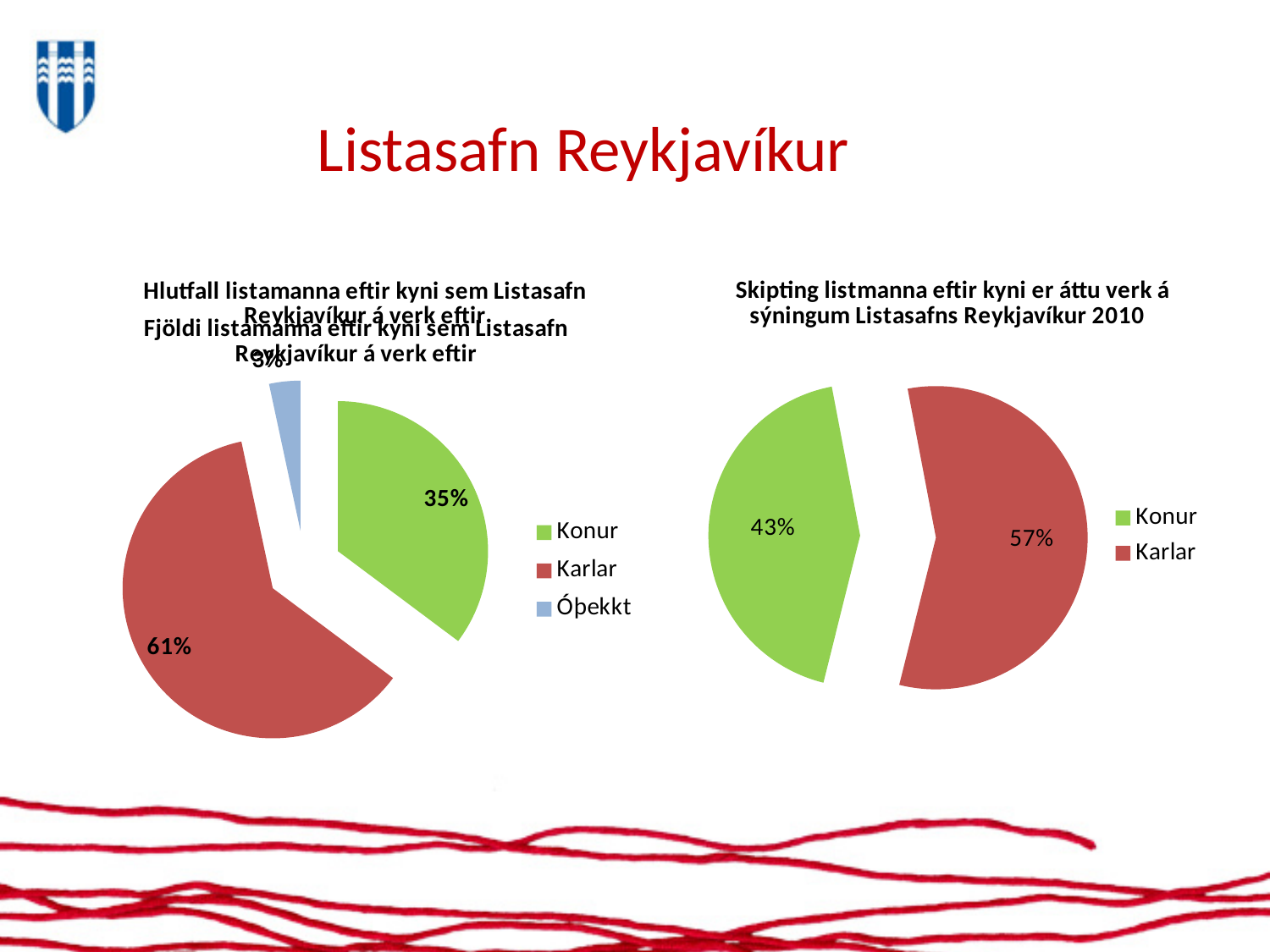
What kind of chart is the right-hand chart on the slide? Pie chart In the chart titled 'Skipting listmanna eftir kyni er áttu verk á sýningum Listasafns Reykjavíkur 2010', what share is labelled for Konur? 43% In the left pie chart, what is the difference in percentage points between Karlar and Konur? 26 In the chart titled 'Skipting listmanna eftir kyni er áttu verk á sýningum Listasafns Reykjavíkur 2010', what share is labelled for Karlar? 57% In the chart titled 'Skipting listmanna eftir kyni er áttu verk á sýningum Listasafns Reykjavíkur 2010', which category has the larger slice? Karlar In the chart titled 'Skipting listmanna eftir kyni er áttu verk á sýningum Listasafns Reykjavíkur 2010', what is the difference in percentage points between Karlar and Konur? 14 In the left pie chart, what share is labelled for Konur? 35% In the left pie chart, how many categories does the legend list? 3 In the left pie chart, what share is labelled for Karlar? 61% In the left pie chart, which category has the largest slice? Karlar In the right pie chart, what colour is the Konur slice? Green In the left pie chart, which category has the smallest slice? Óþekkt